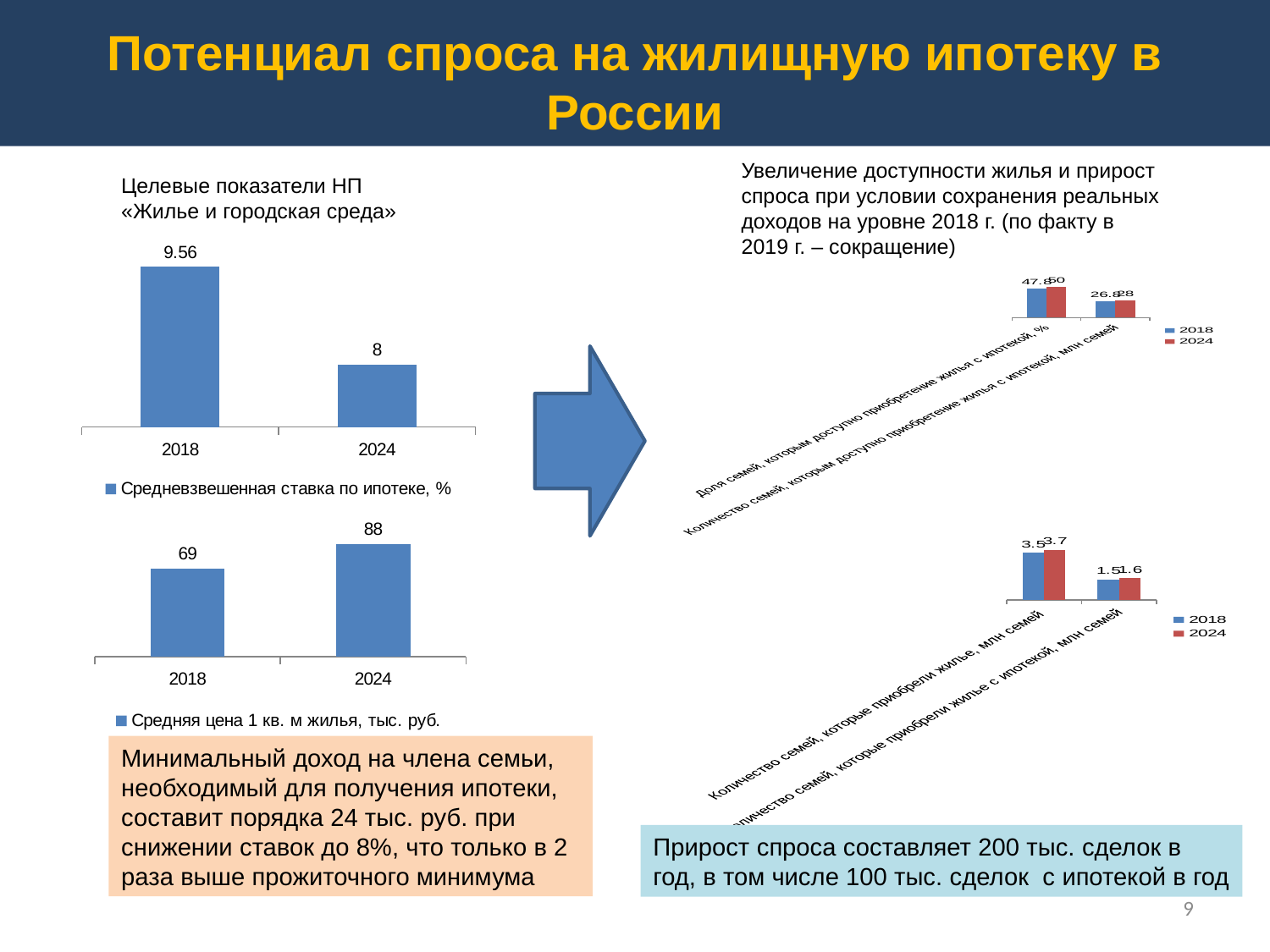
In the top-left chart (Средневзвешенная ставка по ипотеке, %), what is the value for 2024? 8 In the bottom-left chart (Средняя цена 1 кв. м жилья, тыс. руб.), what is the value for 2024? 88 What kind of chart is the top-left chart (Средневзвешенная ставка по ипотеке, %)? bar chart In the top-left chart (Средневзвешенная ставка по ипотеке, %), do the values rise or fall from 2018 to 2024? fall In the bottom-left chart (Средняя цена 1 кв. м жилья, тыс. руб.), what is the difference between the 2024 and 2018 values? 19 How many categories are shown on the x axis of the bottom-left chart (Средняя цена 1 кв. м жилья, тыс. руб.)? 2 How many series does the legend of the top-right chart list? 2 In the top-left chart (Средневзвешенная ставка по ипотеке, %), what is the value for 2018? 9.56 What are the legend entries of the bottom-right chart? 2018, 2024 In the top-left chart (Средневзвешенная ставка по ипотеке, %), by how much does the value for 2018 exceed the value for 2024? 1.56 In the bottom-left chart (Средняя цена 1 кв. м жилья, тыс. руб.), what is the value for 2018? 69 In the bottom-left chart (Средняя цена 1 кв. м жилья, тыс. руб.), which year has the higher value? 2024